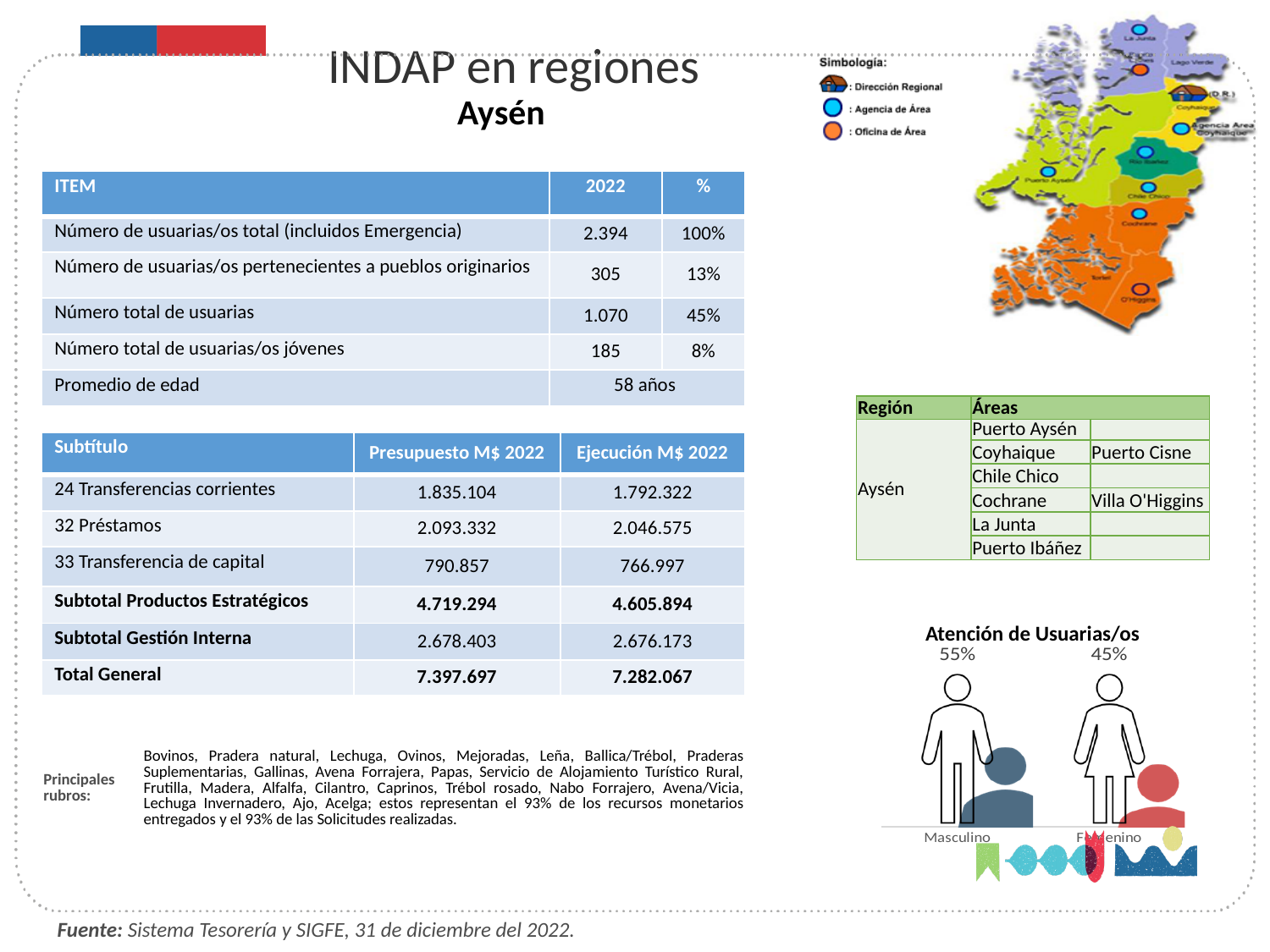
In the 'Atención de Usuarias/os' chart, which category has the highest value? Masculino How many categories are shown in the 'Atención de Usuarias/os' chart? 2 What is the title of the chart on the lower right of the slide? Atención de Usuarias/os In the 'Atención de Usuarias/os' chart, which category has the lowest value? Femenino In the 'Atención de Usuarias/os' chart, what is the value for Masculino? 55% In the 'Atención de Usuarias/os' chart, what is the value for Femenino? 45% In the 'Atención de Usuarias/os' chart, what is the difference between the Masculino and Femenino values? 10% In the 'Atención de Usuarias/os' chart, which is larger, Masculino or Femenino? Masculino In the 'Atención de Usuarias/os' chart, what do the Masculino and Femenino values add up to? 100%